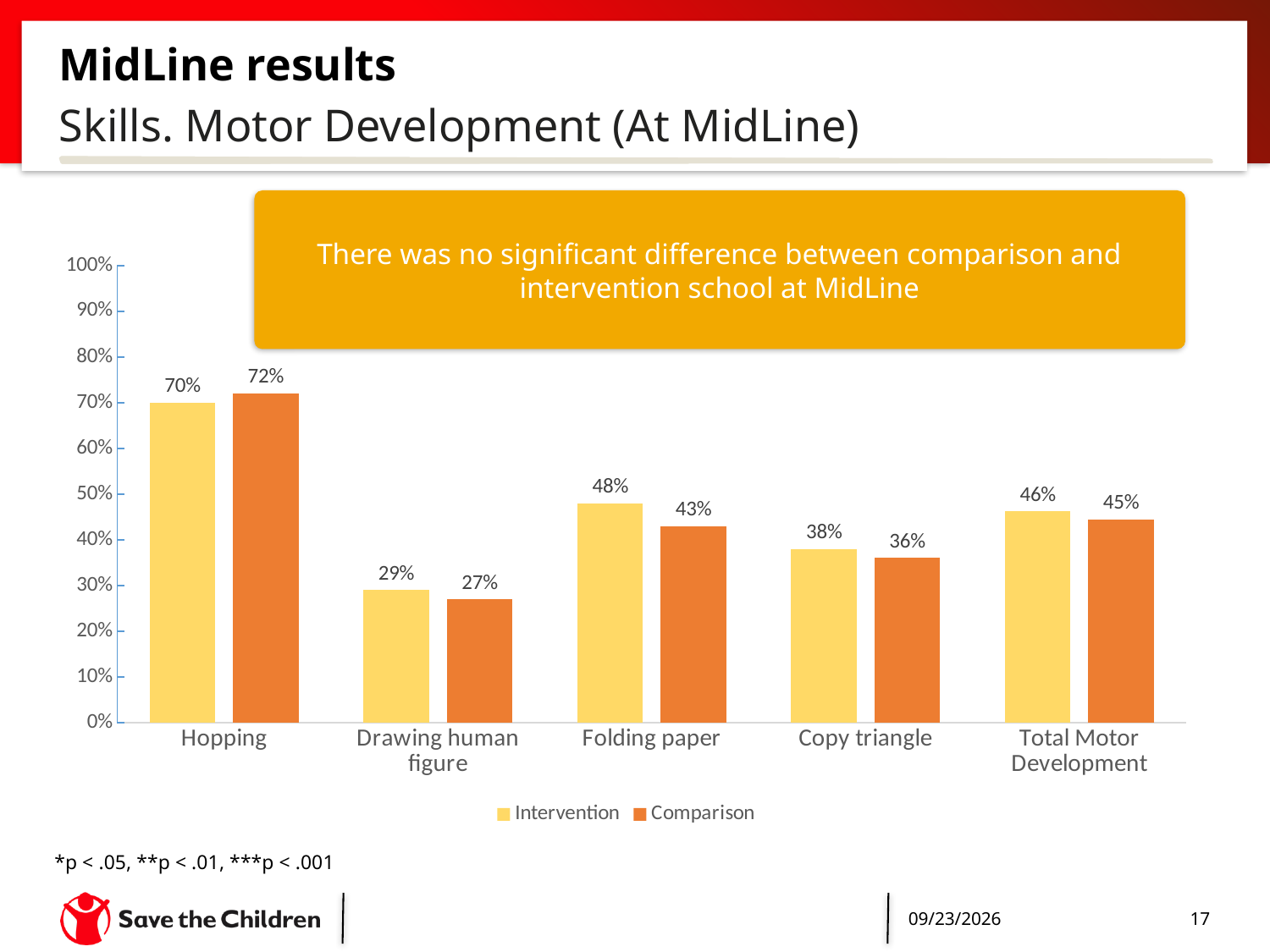
How many series does the legend list? 2 What is the Intervention value for Hopping? 70% What kind of chart is shown on the slide? Bar chart What is the Comparison value for Drawing human figure? 27% Is the Comparison value for Hopping greater or less than 60%? greater What is the Intervention value for Total Motor Development? 46% How many categories are shown on the x axis? 5 For Copy triangle, which series has the larger value, Intervention or Comparison? Intervention Which category has the lowest Intervention value? Drawing human figure What is the difference between the Intervention and Comparison values for Folding paper? 5% Which colour represents the Comparison series? Orange Which category has the highest Comparison value? Hopping